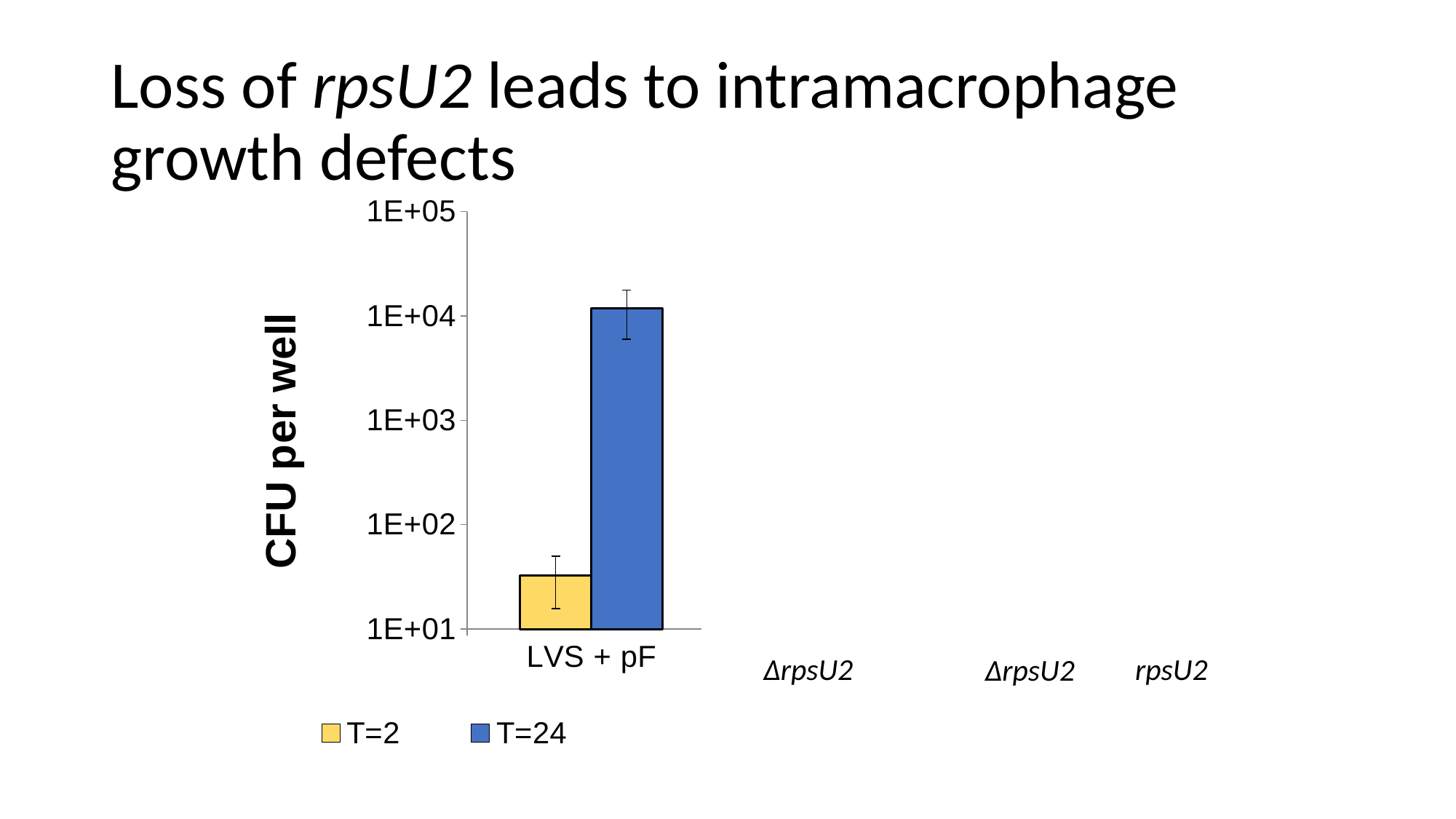
How many categories have bars plotted in the chart? 1 Is the T=2 value for LVS + pF greater or less than 1E+03? less Which category has bars plotted in the chart? LVS + pF What are the two series named in the legend? T=2 and T=24 Is the T=24 value for LVS + pF greater or less than 1E+03? greater For LVS + pF, which series has the larger value, T=2 or T=24? T=24 What kind of chart is shown on the slide? bar chart What is the label of the y-axis? CFU per well Is the T=24 value for LVS + pF greater or less than 1E+02? greater How many series does the legend list? 2